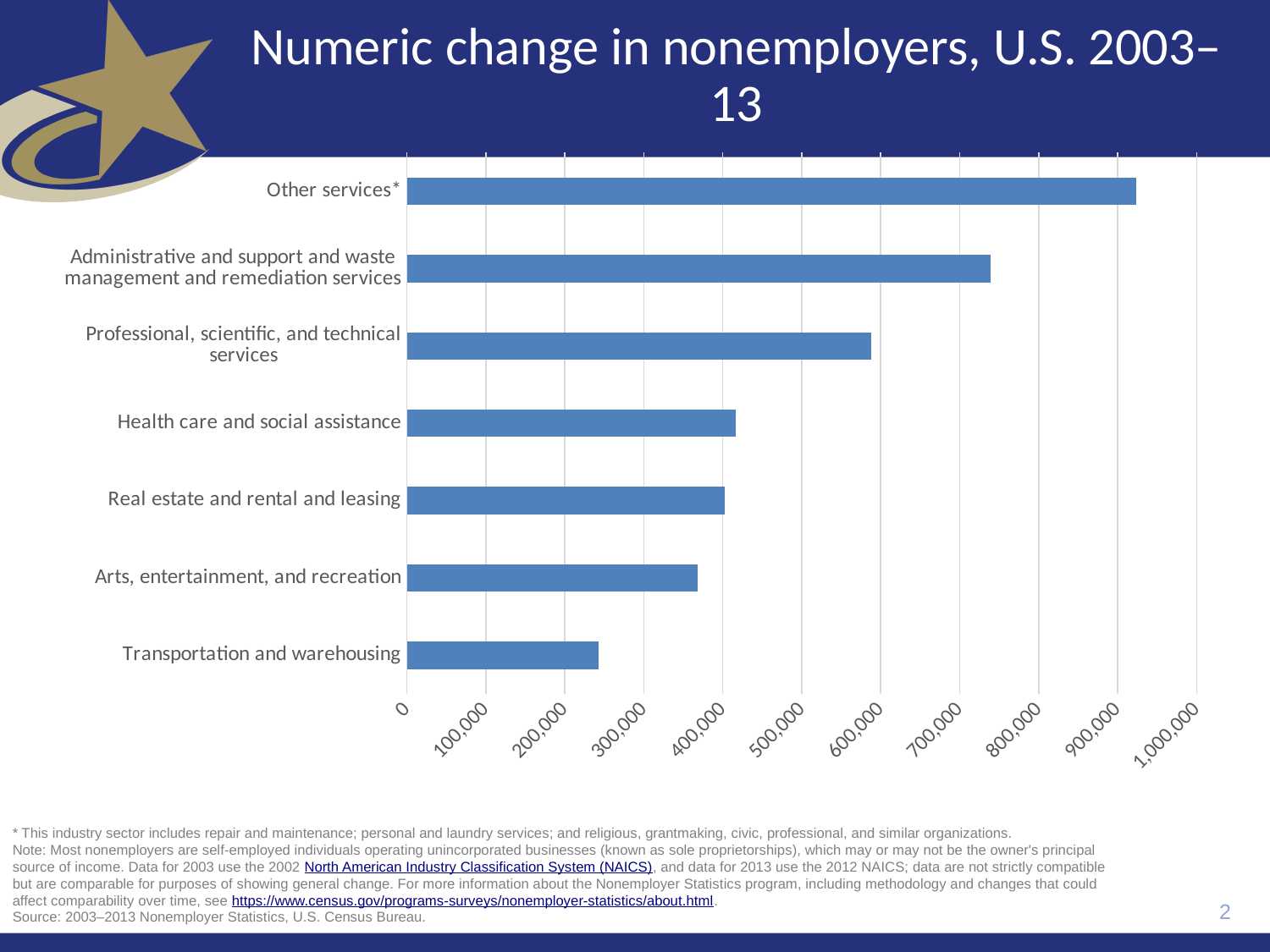
Is the value for Arts, entertainment, and recreation greater or less than 400,000? less Which industry sector has the smallest numeric change in nonemployers? Transportation and warehousing Is the value for Health care and social assistance greater or less than 500,000? less Which is larger: the value for Administrative and support and waste management and remediation services or the value for Professional, scientific, and technical services? Administrative and support and waste management and remediation services Is the value for Administrative and support and waste management and remediation services greater or less than 700,000? greater What kind of chart is shown on the slide? bar chart Which industry sector has the largest numeric change in nonemployers? Other services* What is the title of the chart? Numeric change in nonemployers, U.S. 2003–13 How many industry sectors are shown in the chart? 7